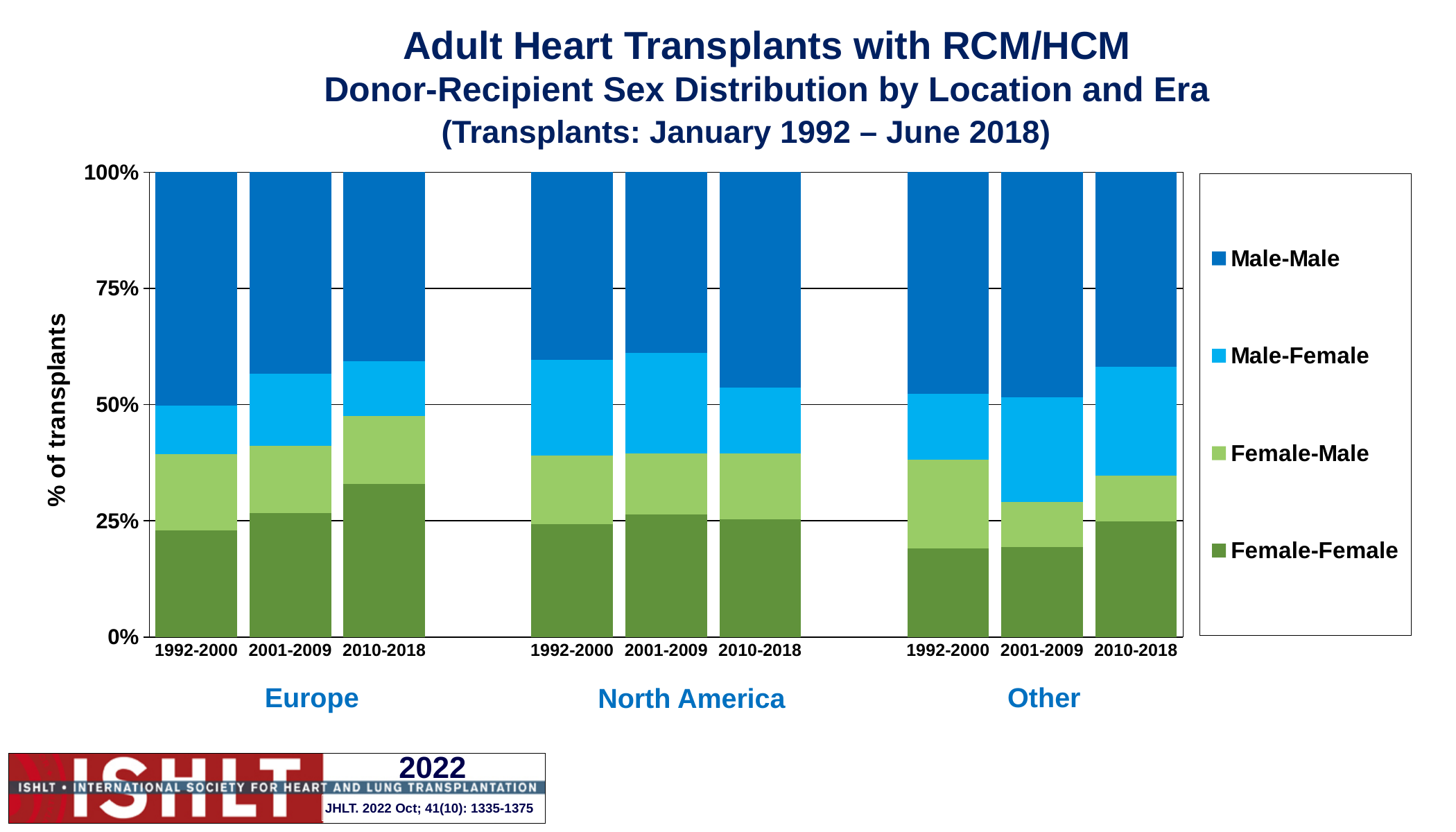
Is the Female-Female share for Europe 2010-2018 greater or less than 25%? greater How many stacked bars are plotted in the chart? 9 Across the three eras for Europe, does the Female-Female share rise or fall? rise Is the Male-Male share for Other 2001-2009 greater or less than 25%? greater Which bar has the largest Female-Female segment? Europe 2010-2018 How many series does the legend list? 4 What is the label of the y axis? % of transplants What kind of chart is shown on the slide? Stacked bar chart Is the Female-Female share for Other 2001-2009 greater or less than 25%? less Which three locations are shown along the x axis? Europe, North America, Other Is the Female-Female share larger for Europe 2010-2018 or for Other 2001-2009? Europe 2010-2018